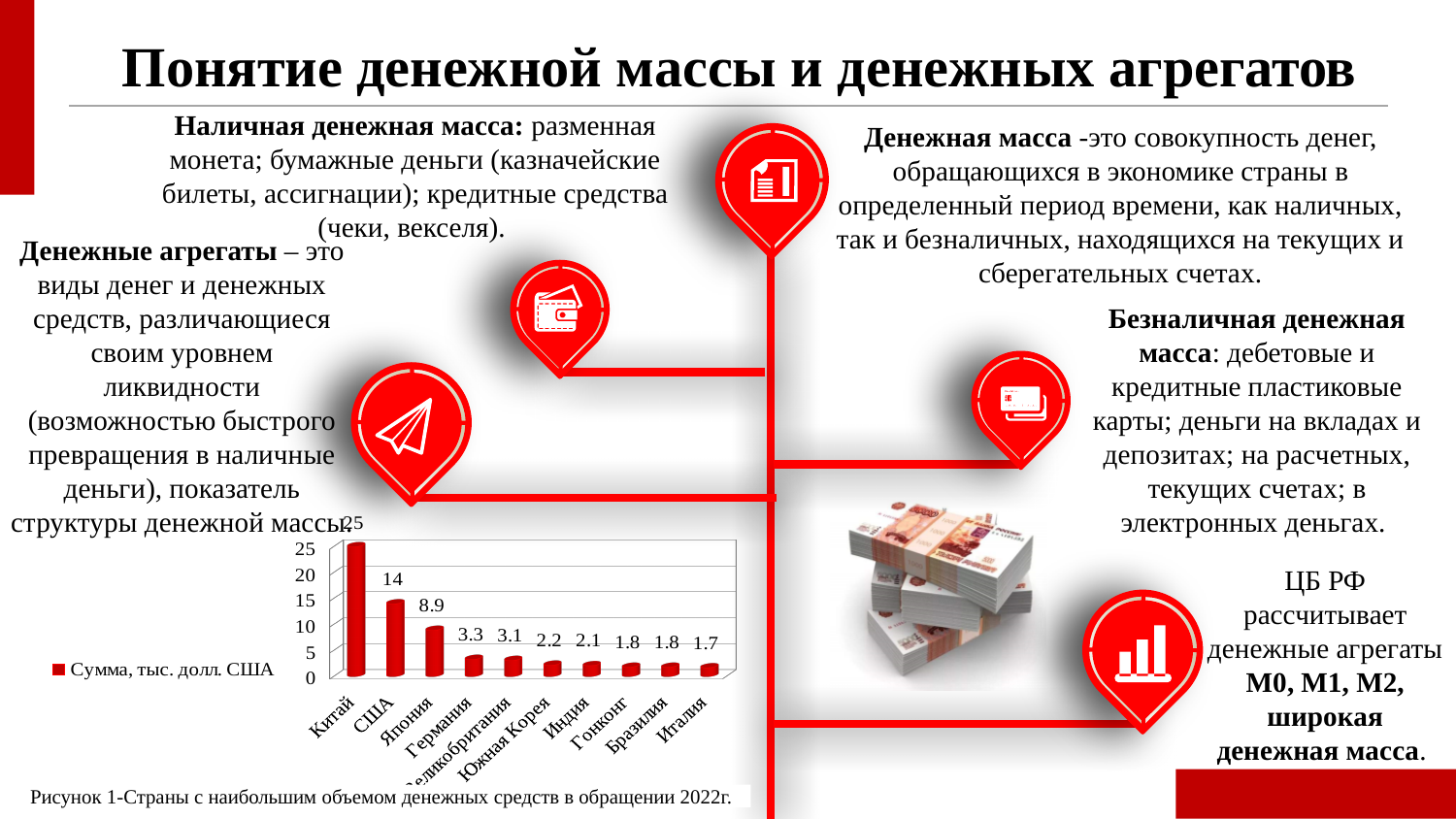
What is the value for Китай in the chart? 25 Which country has the highest value in the chart? Китай How many countries are shown in the chart? 10 Which country has the lowest value in the chart? Италия What type of chart is shown on the slide? bar chart What is the difference between the values for Китай and США? 11 Which is larger, the value for Япония or the value for Германия? Япония What is the value for Италия in the chart? 1.7 What is the value for Япония in the chart? 8.9 What is the legend entry of the chart? Сумма, тыс. долл. США What is the value for США in the chart? 14 What is the value for Германия in the chart? 3.3